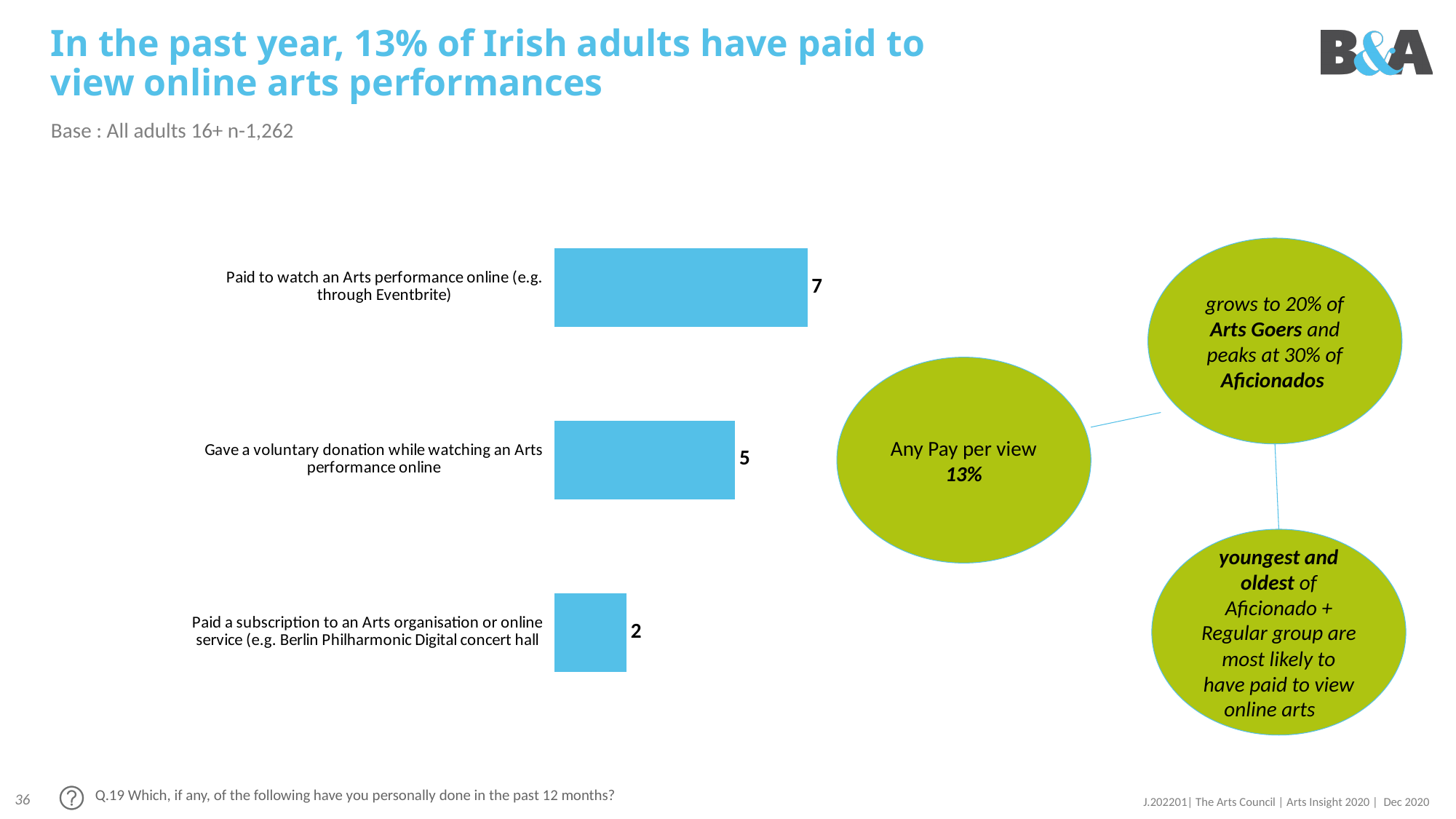
Which category has the highest value? Paid to watch an Arts performance online (e.g. through Eventbrite) Which is larger: the value for 'Paid to watch an Arts performance online' or 'Paid a subscription to an Arts organisation or online service'? Paid to watch an Arts performance online How many categories are shown in the bar chart? 3 What is the value for 'Gave a voluntary donation while watching an Arts performance online'? 5 What is the difference between the value for 'Paid to watch an Arts performance online' and 'Gave a voluntary donation while watching an Arts performance online'? 2 What is the value for 'Paid to watch an Arts performance online (e.g. through Eventbrite)'? 7 What is the value for 'Paid a subscription to an Arts organisation or online service'? 2 Which category has the lowest value? Paid a subscription to an Arts organisation or online service What colour are the bars in the chart? Blue What kind of chart is shown on the slide? Bar chart What is the difference between the value for 'Gave a voluntary donation while watching an Arts performance online' and 'Paid a subscription to an Arts organisation or online service'? 3 What percentage is shown in the 'Any Pay per view' circle? 13%